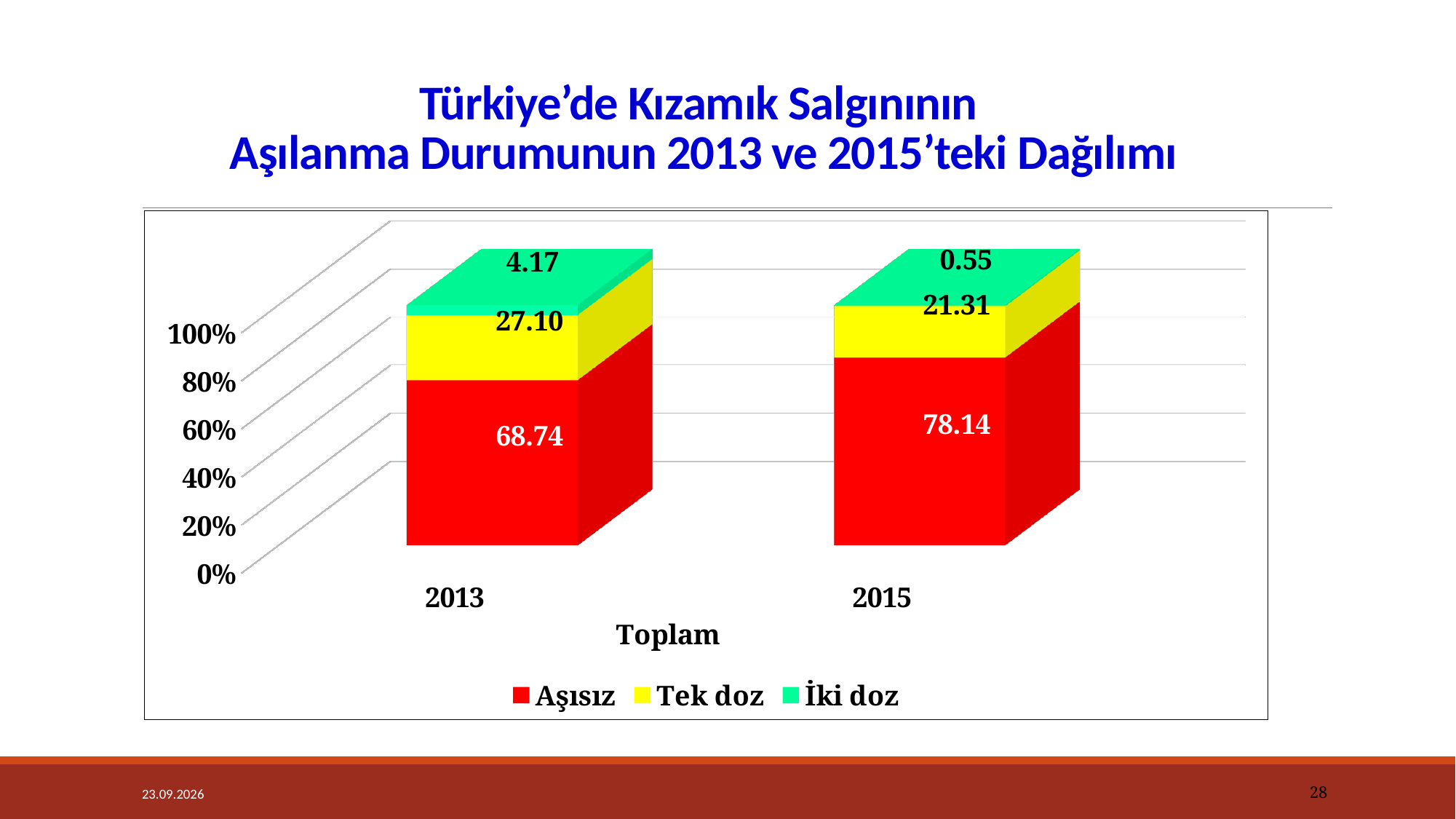
What is the value for Tek doz in 2015? 21.31 How many categories are shown on the x axis? 2 What is the difference between the Aşısız values for 2015 and 2013? 9.40 Which year has the higher value for Aşısız, 2013 or 2015? 2015 What is the value for Aşısız in 2015? 78.14 Which year has the lower value for İki doz? 2015 What is the value for İki doz in 2013? 4.17 Which colour represents Tek doz in the legend? Yellow How many series does the legend list? 3 What is the difference between the Tek doz values for 2013 and 2015? 5.79 What is the value for Aşısız in 2013? 68.74 What kind of chart is shown on the slide? Stacked bar chart